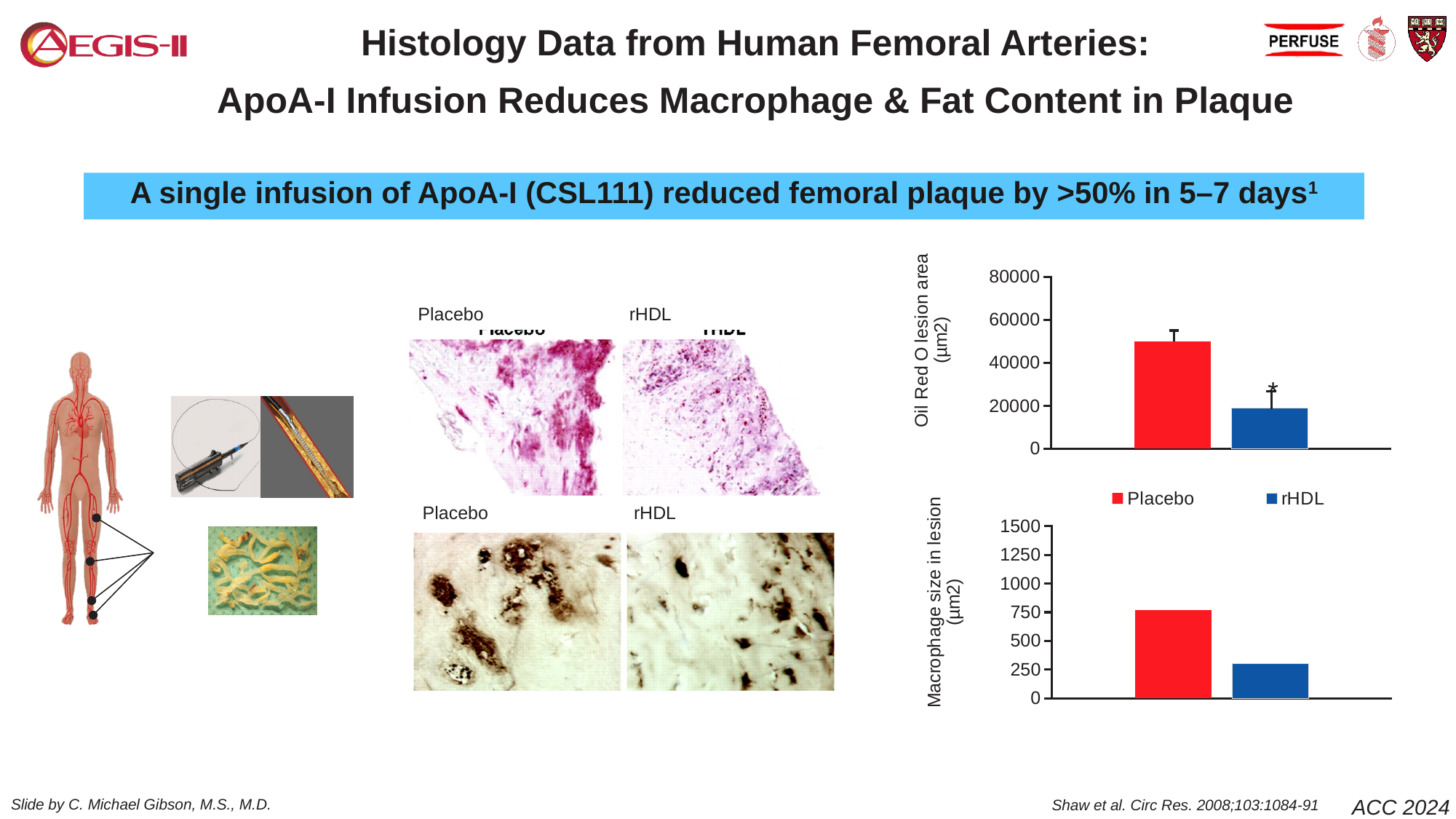
In the Oil Red O lesion area chart, is the value for rHDL greater or less than 40000? less What kind of chart is the bottom chart on the right (Macrophage size in lesion)? bar chart What colour are the Placebo bars in the two charts on the right? red In the Macrophage size in lesion chart, which group has the highest value? Placebo What is the y-axis label of the bottom chart on the right? Macrophage size in lesion (µm2) What kind of chart is the top chart on the right (Oil Red O lesion area)? bar chart In the Macrophage size in lesion chart, which group has the lower value? rHDL How many series does the legend between the two charts list? 2 In the Oil Red O lesion area chart, which group has the higher value, Placebo or rHDL? Placebo In the Oil Red O lesion area chart, is the value for Placebo greater or less than 40000? greater In the Macrophage size in lesion chart, is the value for rHDL greater or less than 500? less